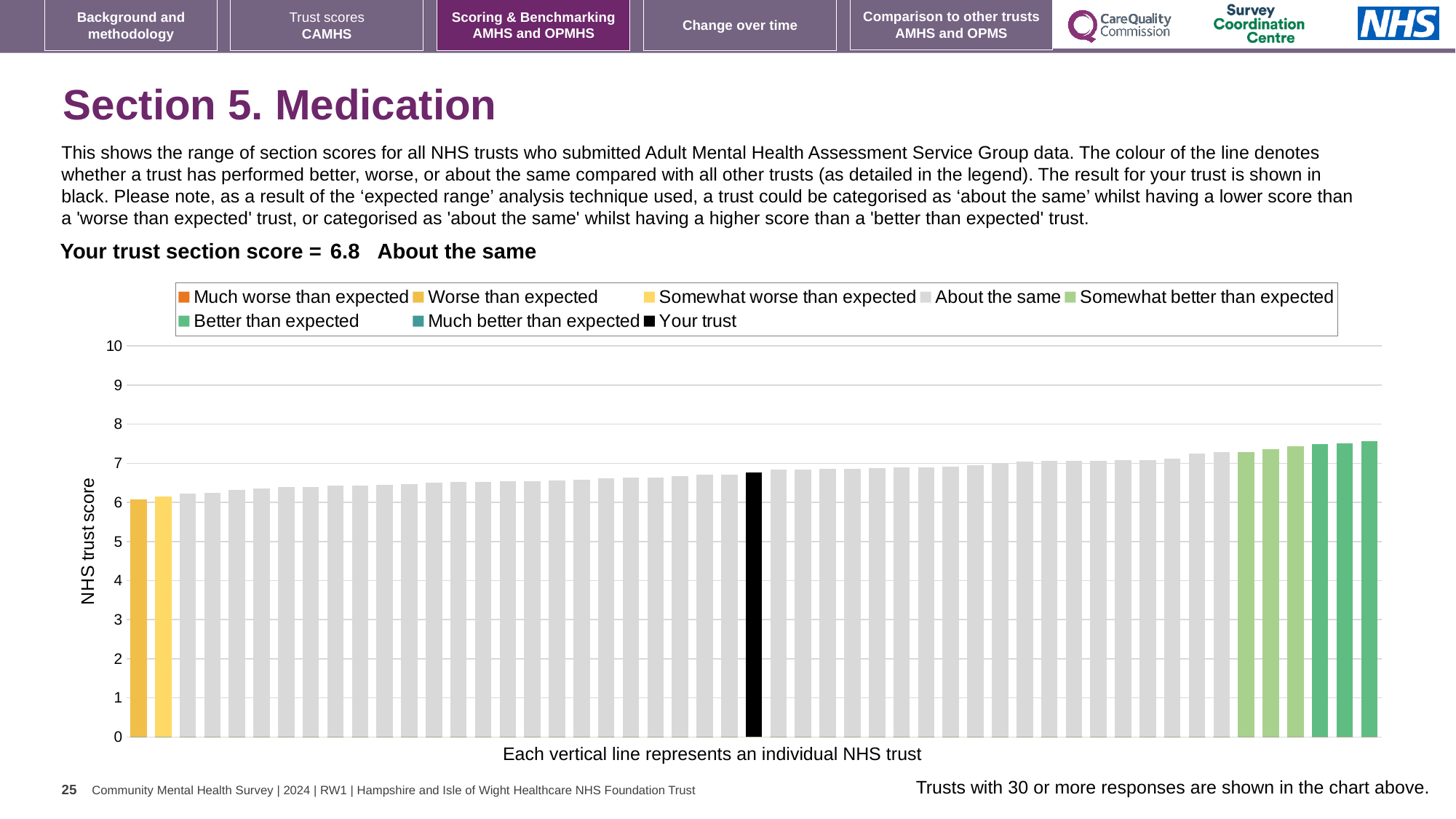
What type of chart is shown on the slide? bar chart Is the value of the tallest bar (rightmost) greater or less than 8? less What colour is the bar representing your trust? black Is the value of the tallest bar (rightmost) greater or less than 7? greater Do the bar values rise or fall from left to right along the x axis? rise What is the section score for your trust shown on the slide? 6.8 Is the value of the leftmost bar greater or less than 7? less What is the label on the vertical axis of the chart? NHS trust score How many entries does the chart legend list? 8 Which bar is taller, the leftmost bar or the rightmost bar? the rightmost bar